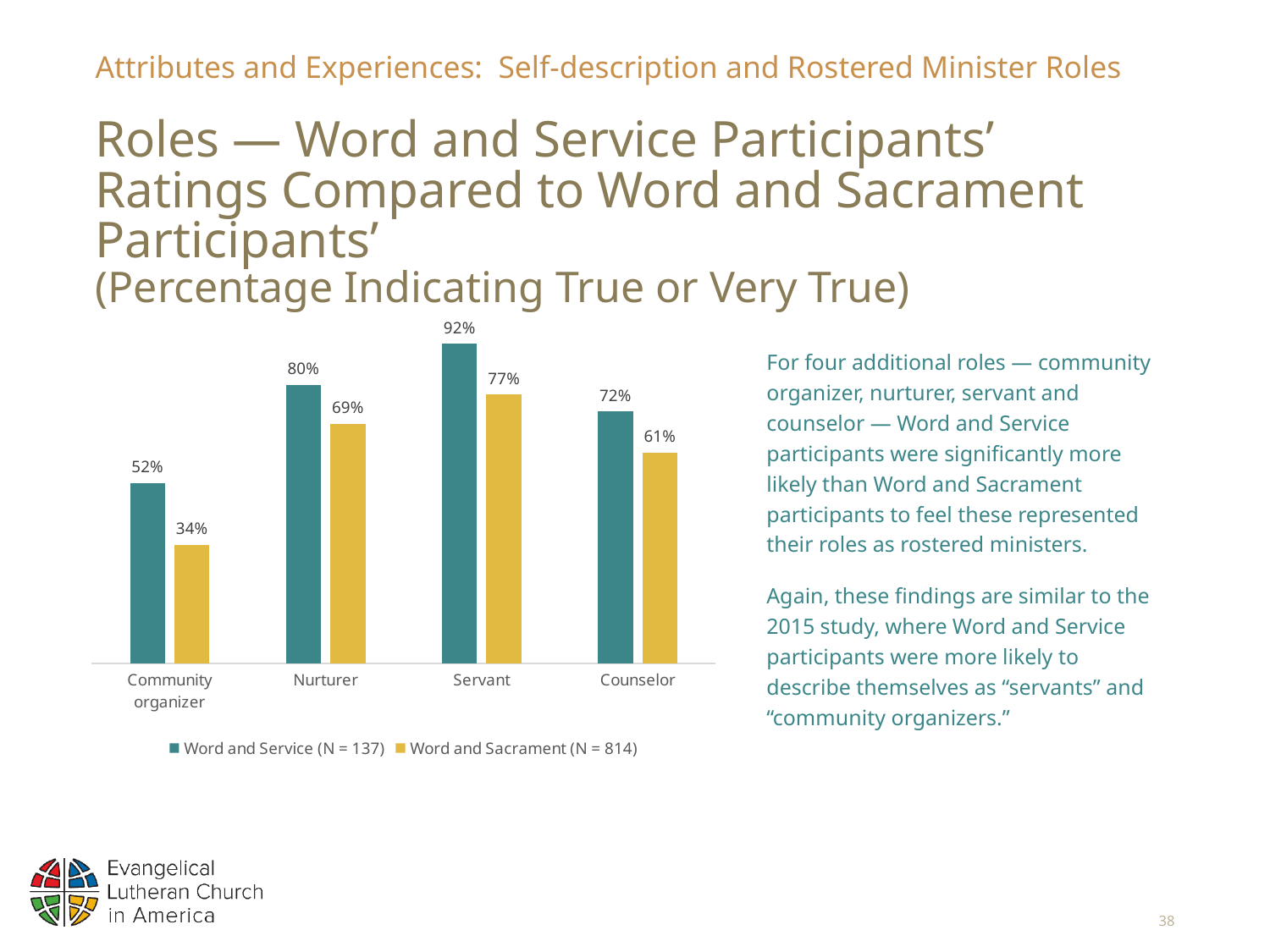
How many series does the legend list? 2 What is the Word and Service value for Servant? 92% Which role has the lowest Word and Sacrament value? Community organizer What is the Word and Sacrament value for Nurturer? 69% Which is larger for Nurturer: the Word and Service value or the Word and Sacrament value? Word and Service What percentage of Word and Service participants rated Community organizer as true or very true? 52% What is the Word and Sacrament value for Counselor? 61% What is the difference between the Word and Service and Word and Sacrament values for Community organizer? 18% What is the difference between the Word and Service and Word and Sacrament values for Servant? 15% How many roles are shown on the x axis of the chart? 4 What kind of chart is shown on the slide? Bar chart Which role has the highest Word and Service value? Servant